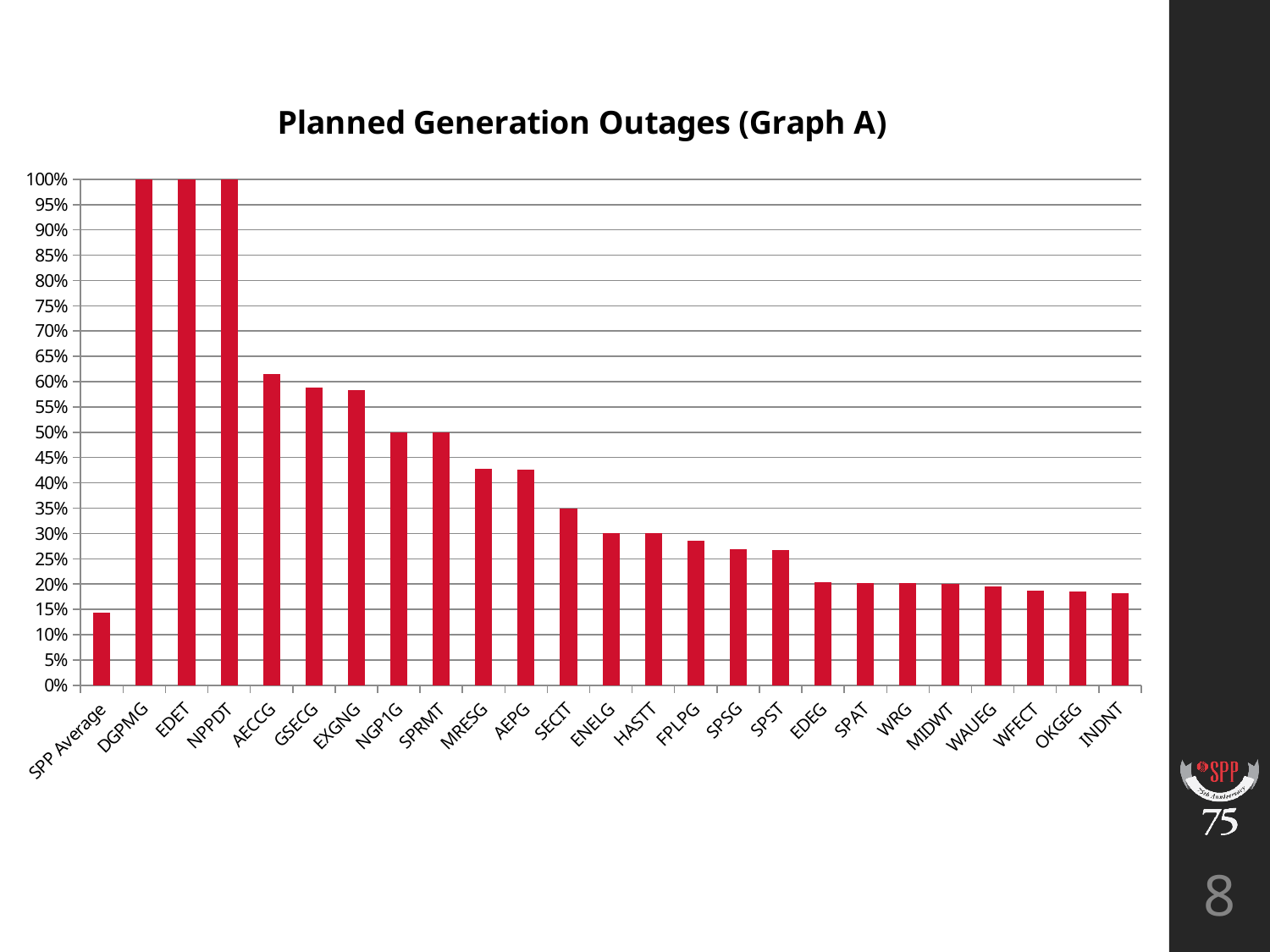
Is the value for MRESG greater or less than 40%? greater Which is larger, the value for SPSG or the value for EDEG? SPSG How many categories are shown on the x axis of the chart? 25 What is the title of the chart? Planned Generation Outages (Graph A) Which category has the lowest bar in the chart? SPP Average Is the value for SPP Average greater or less than 20%? less Is the value for SECIT greater or less than 40%? less What is the value for NPPDT? 100% What kind of chart is shown on the slide? bar chart What is the value for DGPMG? 100% Excluding the SPP Average bar, do the values generally rise or fall from left to right along the x axis? fall